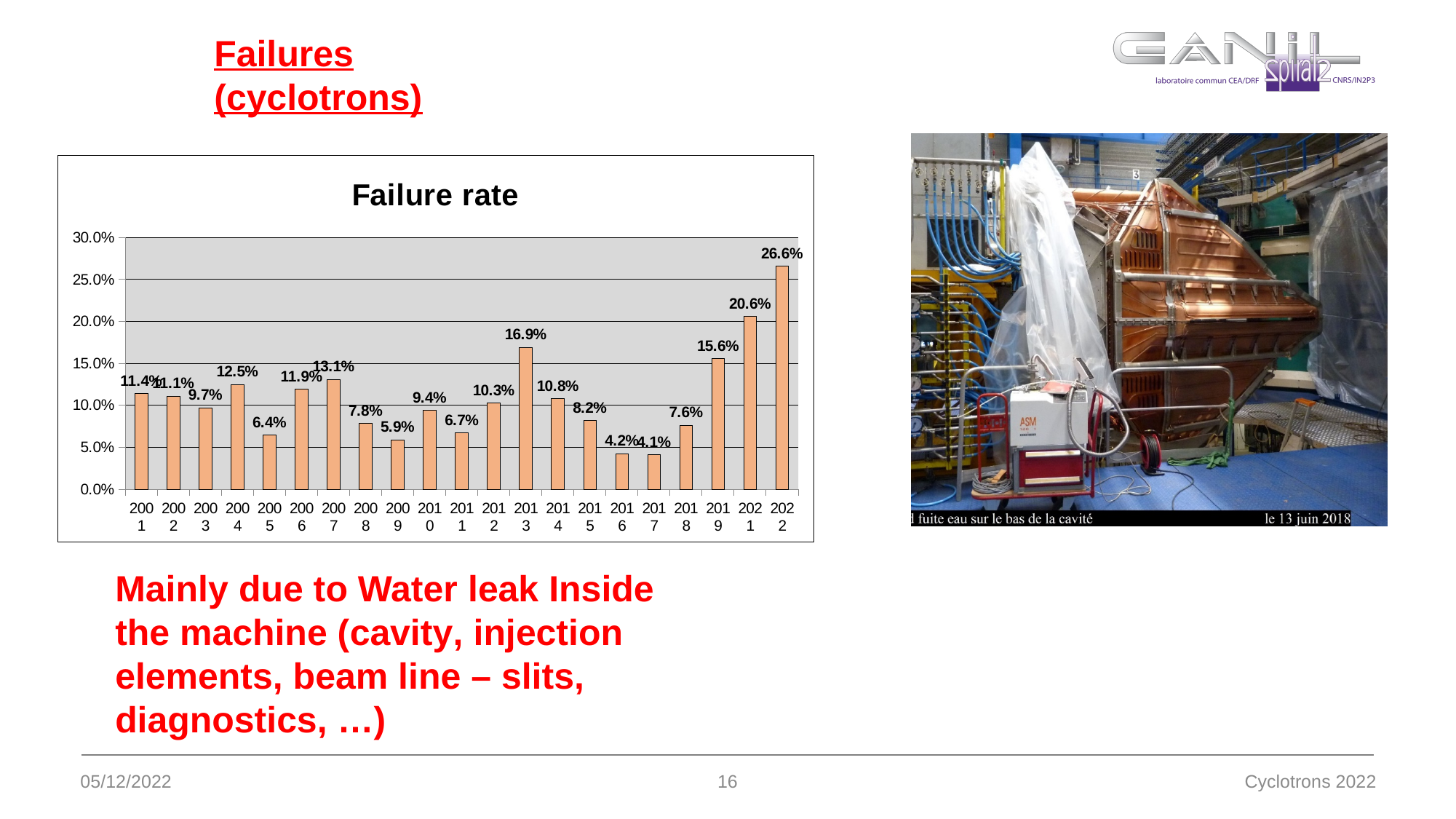
What is the failure rate shown for 2022? 26.6% What is the difference between the failure rates for 2022 and 2021? 6.0% Which year has a higher failure rate, 2019 or 2013? 2013 What is the title of the chart? Failure rate Do the failure rates rise or fall from 2018 to 2022? Rise What is the failure rate shown for 2005? 6.4% Which year has the lowest failure rate? 2017 Which year has the highest failure rate? 2022 How many years (bars) are shown in the Failure rate chart? 21 What kind of chart is used to show the failure rate? Bar chart Is the failure rate for 2021 greater or less than 20.0%? greater What is the failure rate shown for 2013? 16.9%